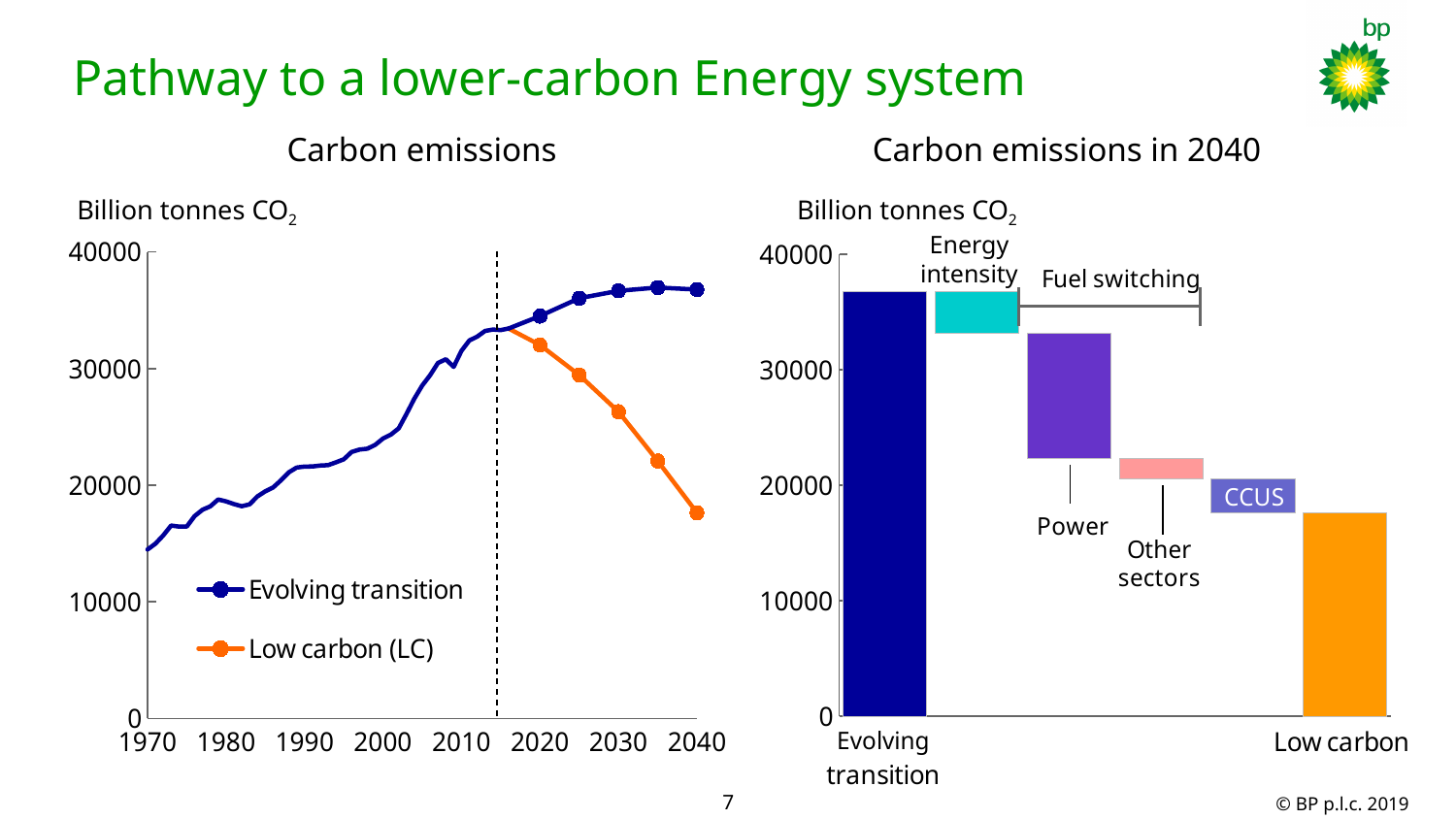
In the 'Carbon emissions' chart on the left, what are the two series named in the legend? Evolving transition and Low carbon (LC) In the 'Carbon emissions' chart on the left, which series has the higher value in 2040, Evolving transition or Low carbon (LC)? Evolving transition In the 'Carbon emissions in 2040' chart on the right, which reduction step between Evolving transition and Low carbon is the largest? Power In the 'Carbon emissions' chart on the left, what kind of chart is it? line chart In the 'Carbon emissions' chart on the left, is the Evolving transition value in 2040 greater or less than 30000? greater In the 'Carbon emissions' chart on the left, how many series does the legend list? 2 In the 'Carbon emissions in 2040' chart on the right, what kind of chart is it? bar chart In the 'Carbon emissions' chart on the left, is the Low carbon (LC) value in 2040 greater or less than 20000? less In the 'Carbon emissions' chart on the left, what unit is shown on the y axis? Billion tonnes CO2 In the 'Carbon emissions in 2040' chart on the right, is the Low carbon bar greater or less than 20000? less In the 'Carbon emissions' chart on the left, does the Low carbon (LC) series rise or fall between 2020 and 2040? fall